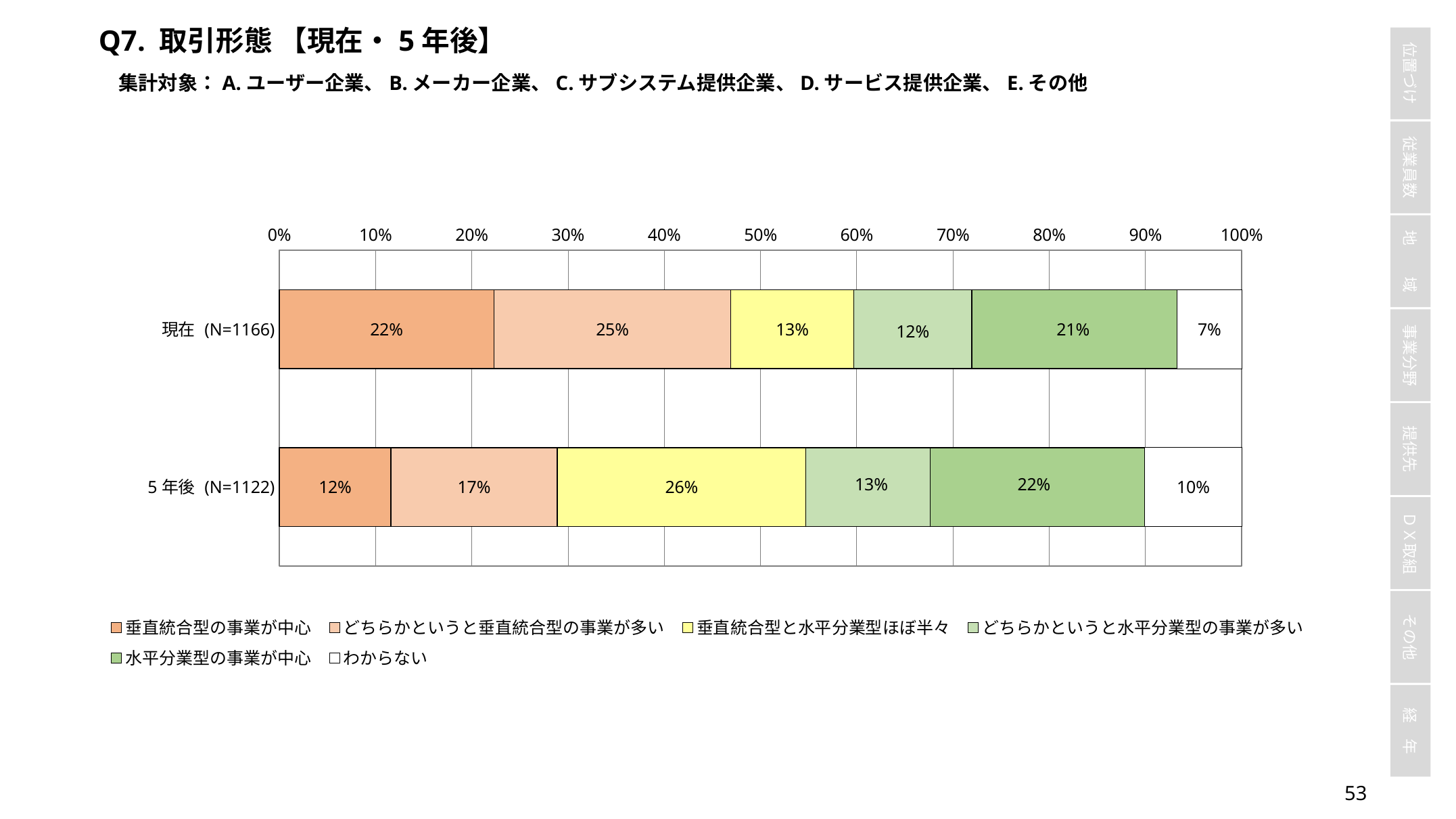
What is the value for わからない in the 5年後 (N=1122) bar? 10% Which is larger: 水平分業型の事業が中心 for 現在 (N=1166) or for 5年後 (N=1122)? 5年後 (N=1122) Which segment is the smallest in the 現在 (N=1166) bar? わからない What is the difference between the 垂直統合型の事業が中心 values for 現在 (N=1166) and 5年後 (N=1122)? 10% How many categories (bars) are plotted in the chart? 2 What is the sample size (N) shown for the 現在 category? 1166 What kind of chart is shown on the slide? Stacked bar chart What is the value for 垂直統合型と水平分業型ほぼ半々 in the 5年後 (N=1122) bar? 26% What is the value for 垂直統合型の事業が中心 in the 現在 (N=1166) bar? 22% What is the value for どちらかというと垂直統合型の事業が多い in the 現在 (N=1166) bar? 25% Which segment is the largest in the 5年後 (N=1122) bar? 垂直統合型と水平分業型ほぼ半々 How many series does the legend list? 6